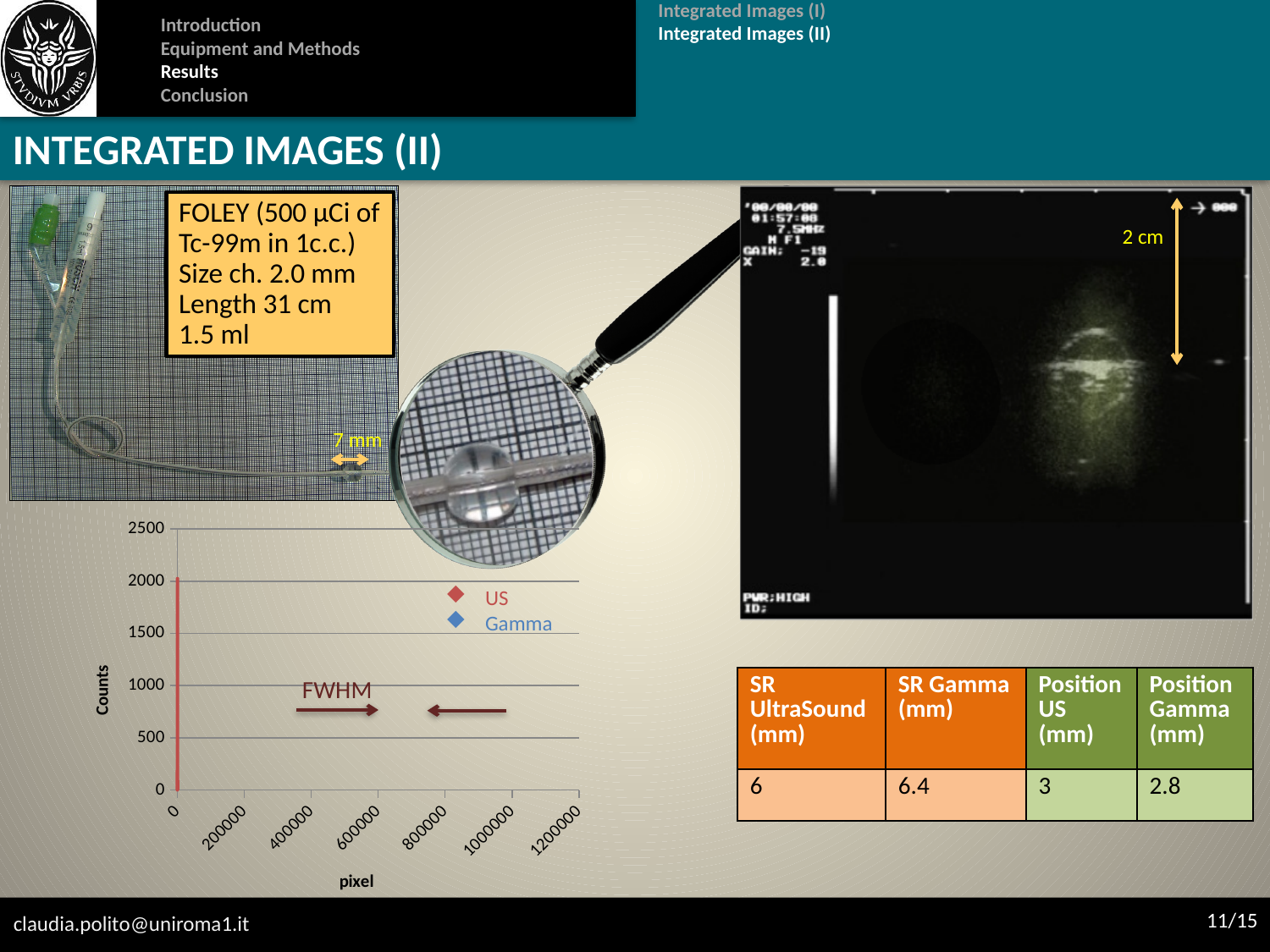
What are the two series named in the legend of the Counts vs pixel chart? US and Gamma How many series does the legend of the Counts vs pixel chart list? 2 What is the label of the vertical axis of the chart at the bottom left? Counts What kind of chart is shown at the bottom left of the slide? scatter chart In the Counts vs pixel chart, is the peak of the US series greater or less than 2500 counts? less In the Counts vs pixel chart, is the peak of the US series greater or less than 1500 counts? greater